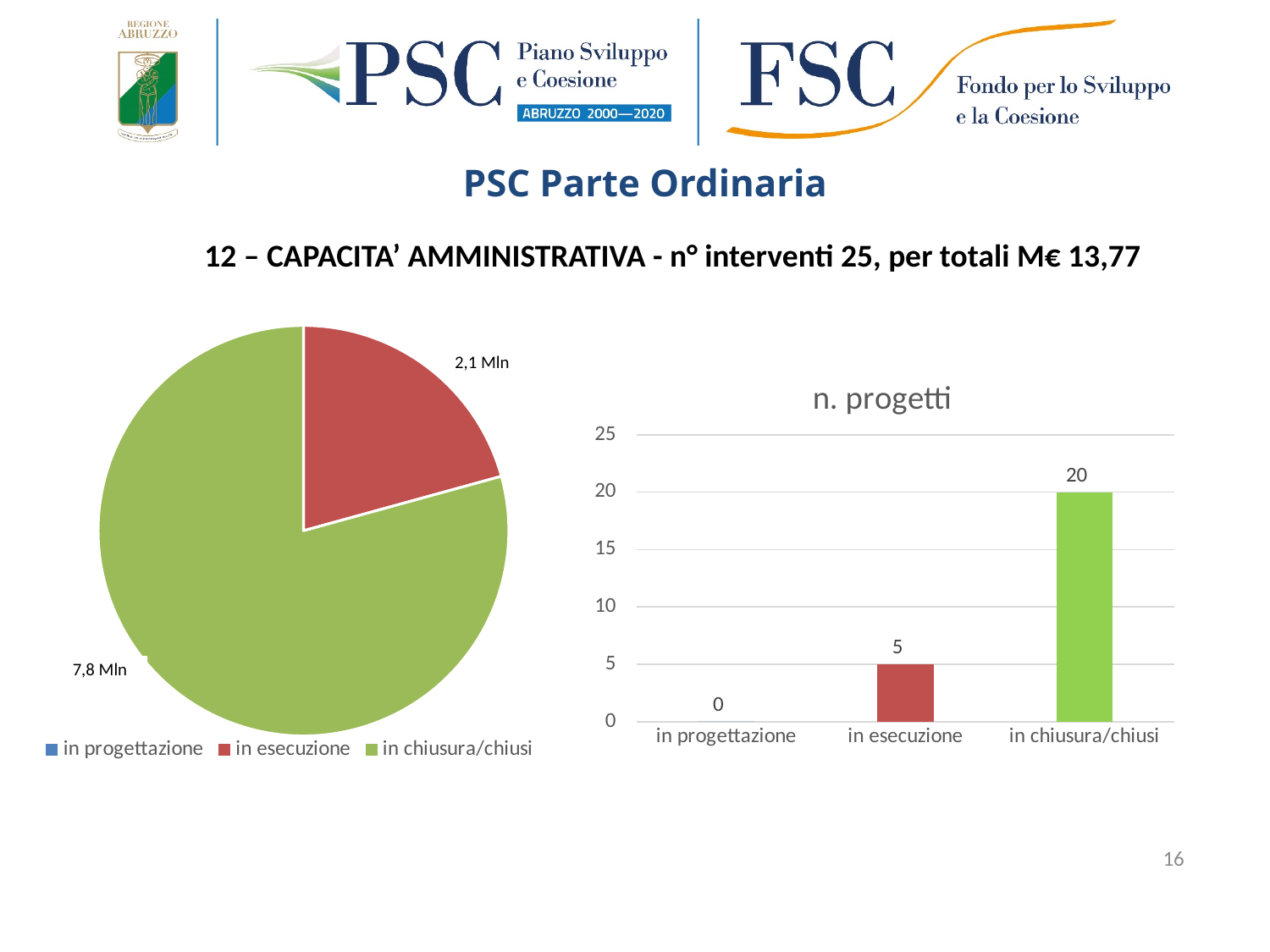
In the bar chart titled "n. progetti", what is the value for "in progettazione"? 0 In the pie chart on the left of the slide, which slice is larger: "in esecuzione" or "in chiusura/chiusi"? in chiusura/chiusi In the pie chart on the left of the slide, what value is labelled for the "in esecuzione" slice? 2,1 Mln What kind of chart is the chart titled "n. progetti" on the right of the slide? bar chart In the bar chart titled "n. progetti", what is the difference between the values for "in chiusura/chiusi" and "in esecuzione"? 15 How many entries does the legend of the pie chart on the left of the slide list? 3 In the pie chart on the left of the slide, what value is labelled for the "in chiusura/chiusi" slice? 7,8 Mln In the bar chart titled "n. progetti", what is the value for "in chiusura/chiusi"? 20 In the bar chart titled "n. progetti", which category has the lowest value? in progettazione In the bar chart titled "n. progetti", what is the value for "in esecuzione"? 5 In the bar chart titled "n. progetti", which category has the highest value? in chiusura/chiusi In the bar chart titled "n. progetti", how many categories are shown on the x axis? 3